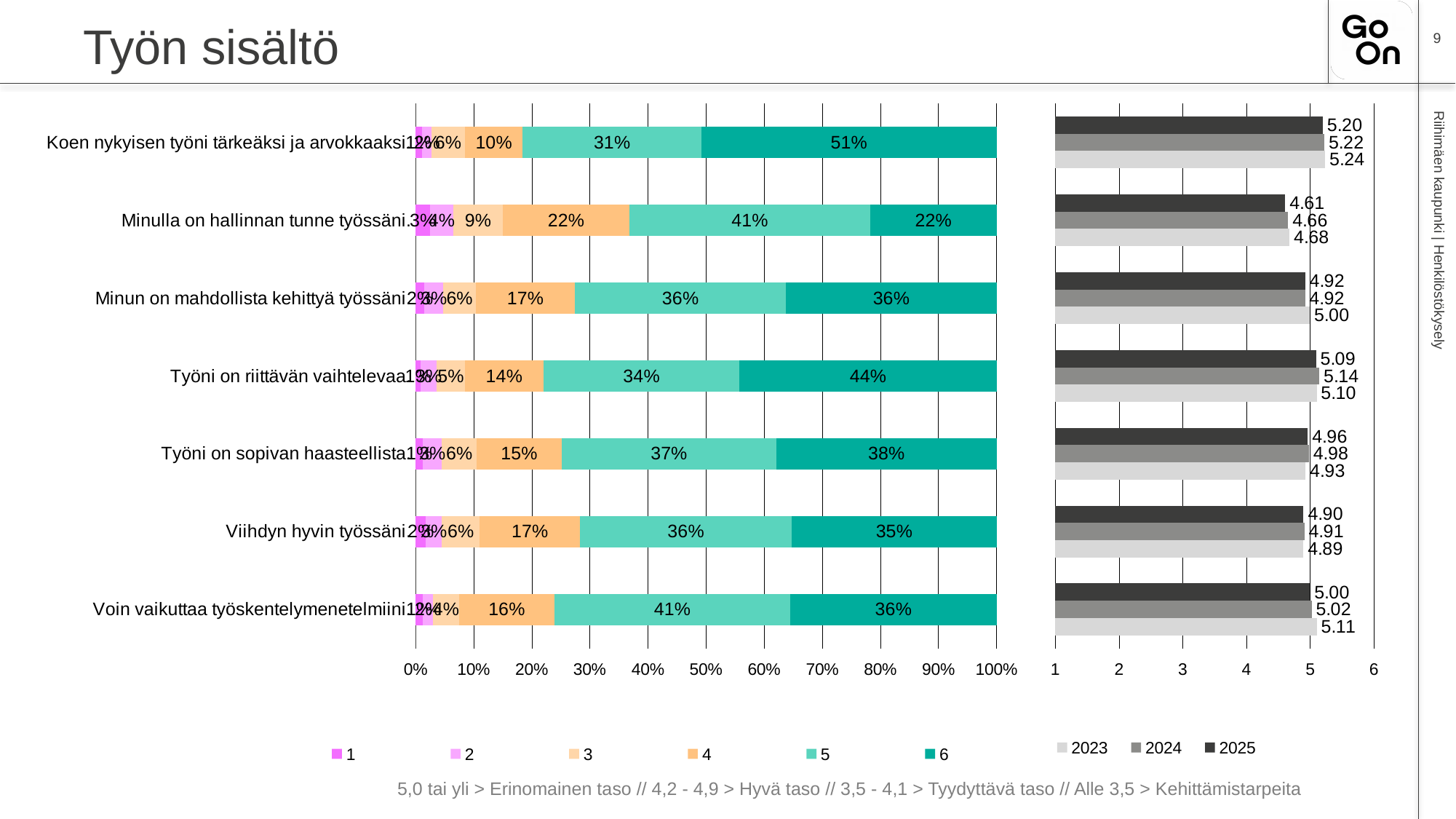
In the right chart, which is larger for "Työni on riittävän vaihtelevaa": the 2024 value or the 2025 value? 2024 In the left stacked bar chart, what percentage gave a rating of 4 for "Työni on riittävän vaihtelevaa"? 14% In the left stacked bar chart, what percentage gave a rating of 5 for "Minulla on hallinnan tunne työssäni"? 41% In the right chart, what is the 2025 value for "Minulla on hallinnan tunne työssäni"? 4.61 In the left stacked bar chart, which statement has the highest share of rating 6? Koen nykyisen työni tärkeäksi ja arvokkaaksi What kind of chart is the chart on the right of the slide? Bar chart In the left stacked bar chart, what percentage of respondents gave a rating of 6 for "Koen nykyisen työni tärkeäksi ja arvokkaaksi"? 51% In the right chart, what is the 2023 value for "Voin vaikuttaa työskentelymenetelmiini"? 5.11 In the left stacked bar chart, how many series does the legend list? 6 In the left stacked bar chart, what is the difference between the rating-6 share and the rating-5 share for "Koen nykyisen työni tärkeäksi ja arvokkaaksi"? 20% In the left stacked bar chart, which statement has the lowest share of rating 6? Minulla on hallinnan tunne työssäni How many statements (categories) are shown in the left stacked bar chart? 7